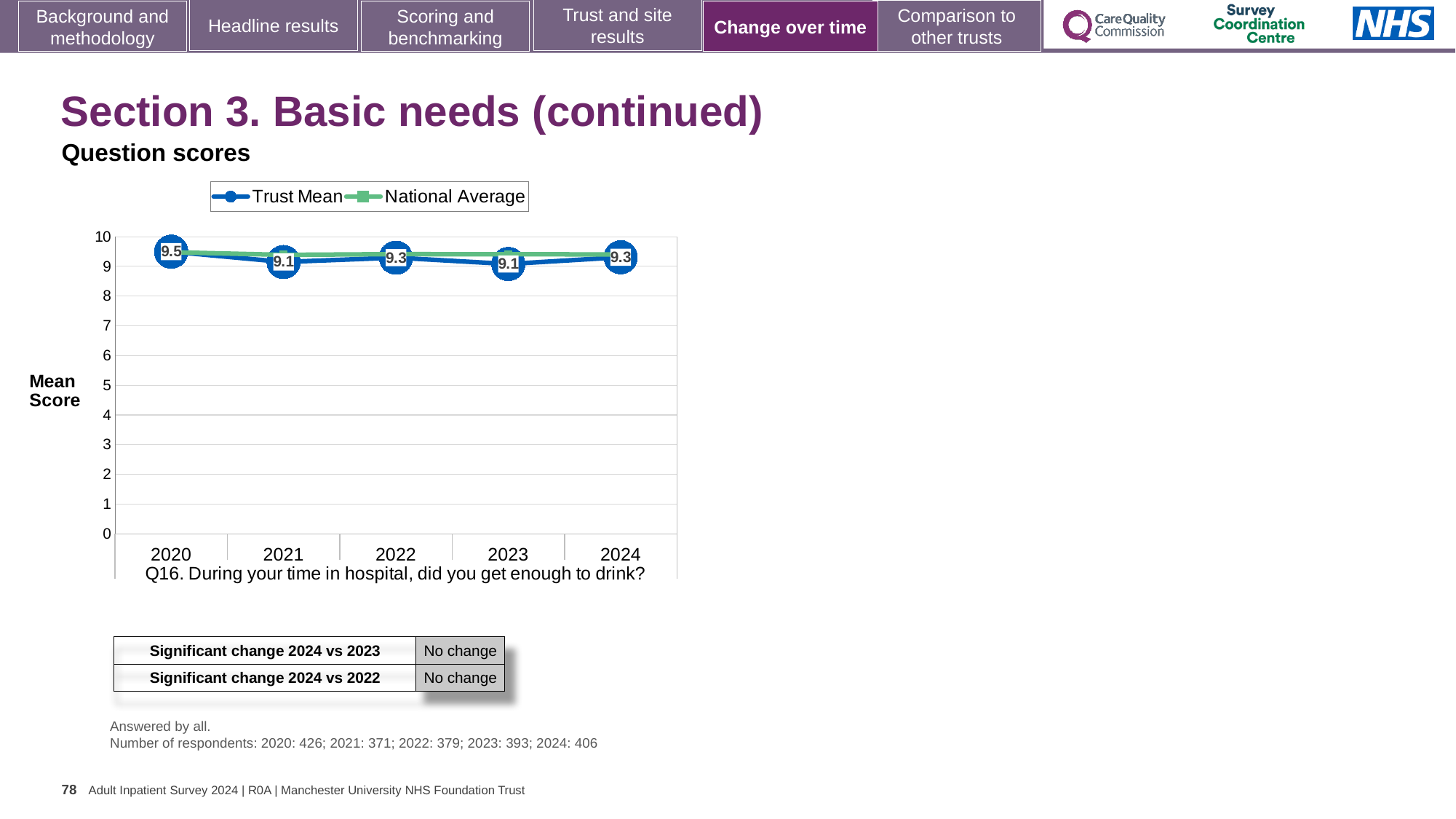
Which survey question does the chart relate to? Q16. During your time in hospital, did you get enough to drink? What is the Trust Mean score for 2024? 9.3 Does the Trust Mean score rise or fall from 2020 to 2021? fall What is the Trust Mean score for 2020? 9.5 What is the Trust Mean score for 2023? 9.1 How many years are shown on the x axis of the chart? 5 In which year is the Trust Mean score highest? 2020 What kind of chart is shown on the slide? line chart Which is larger, the Trust Mean score for 2022 or for 2023? 2022 What is the difference between the Trust Mean scores for 2020 and 2021? 0.4 Is the National Average value for 2024 greater or less than 8? greater How many series does the chart legend list? 2